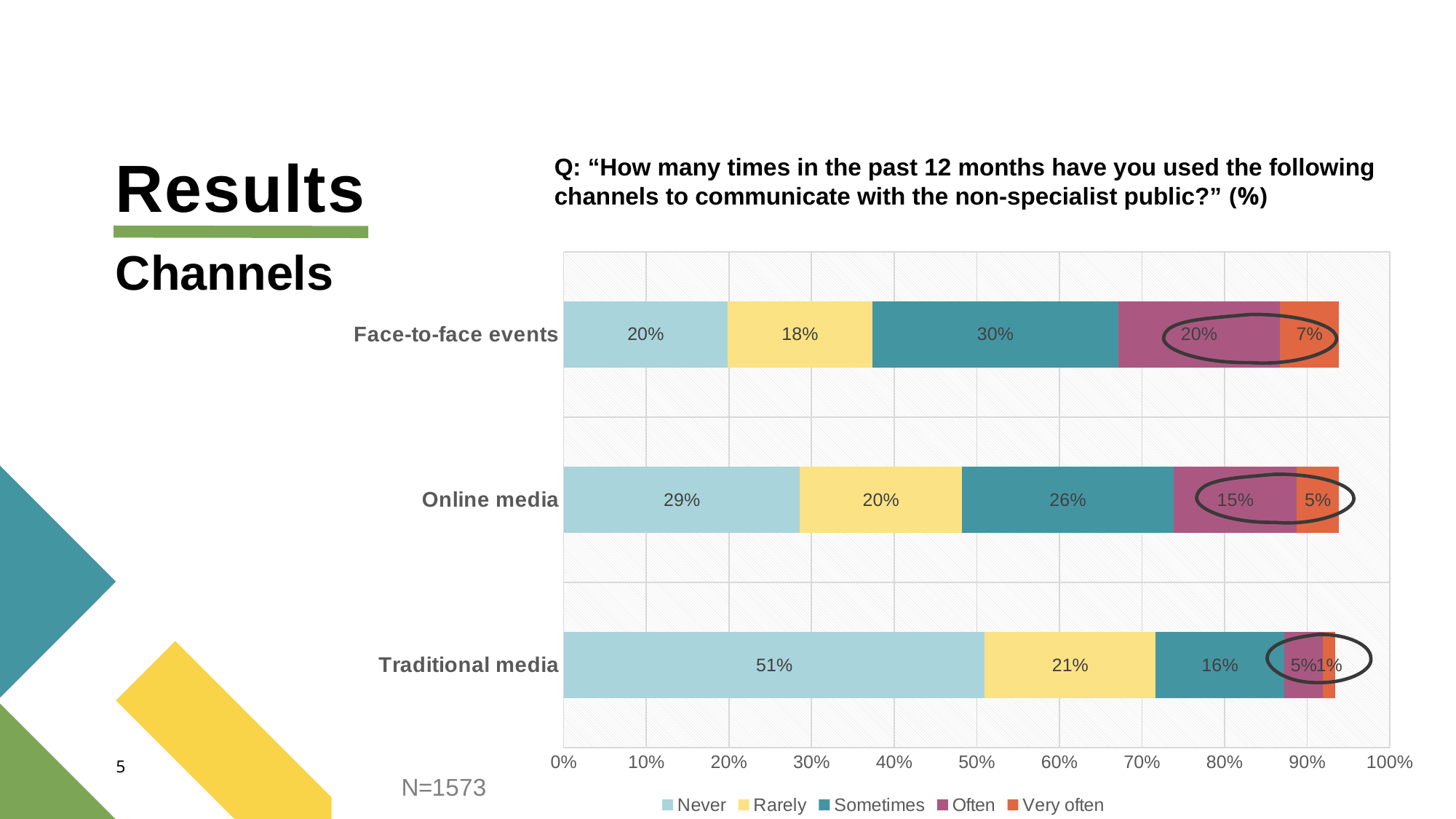
What is the 'Often' value for Online media? 15% How many channels (categories) are plotted in the chart? 3 Which channel has the highest 'Never' value? Traditional media What kind of chart is shown on the slide? Stacked bar chart What is the 'Very often' value for Traditional media? 1% What is the 'Never' value for Traditional media? 51% What is the 'Sometimes' value for Face-to-face events? 30% How many series does the legend list? 5 Which channel has the lowest 'Very often' value? Traditional media Which is larger: the 'Sometimes' value for Face-to-face events or for Online media? Face-to-face events What is the total of the labelled segments in the Face-to-face events bar? 95% What is the difference between the 'Never' values for Traditional media and Online media? 22%